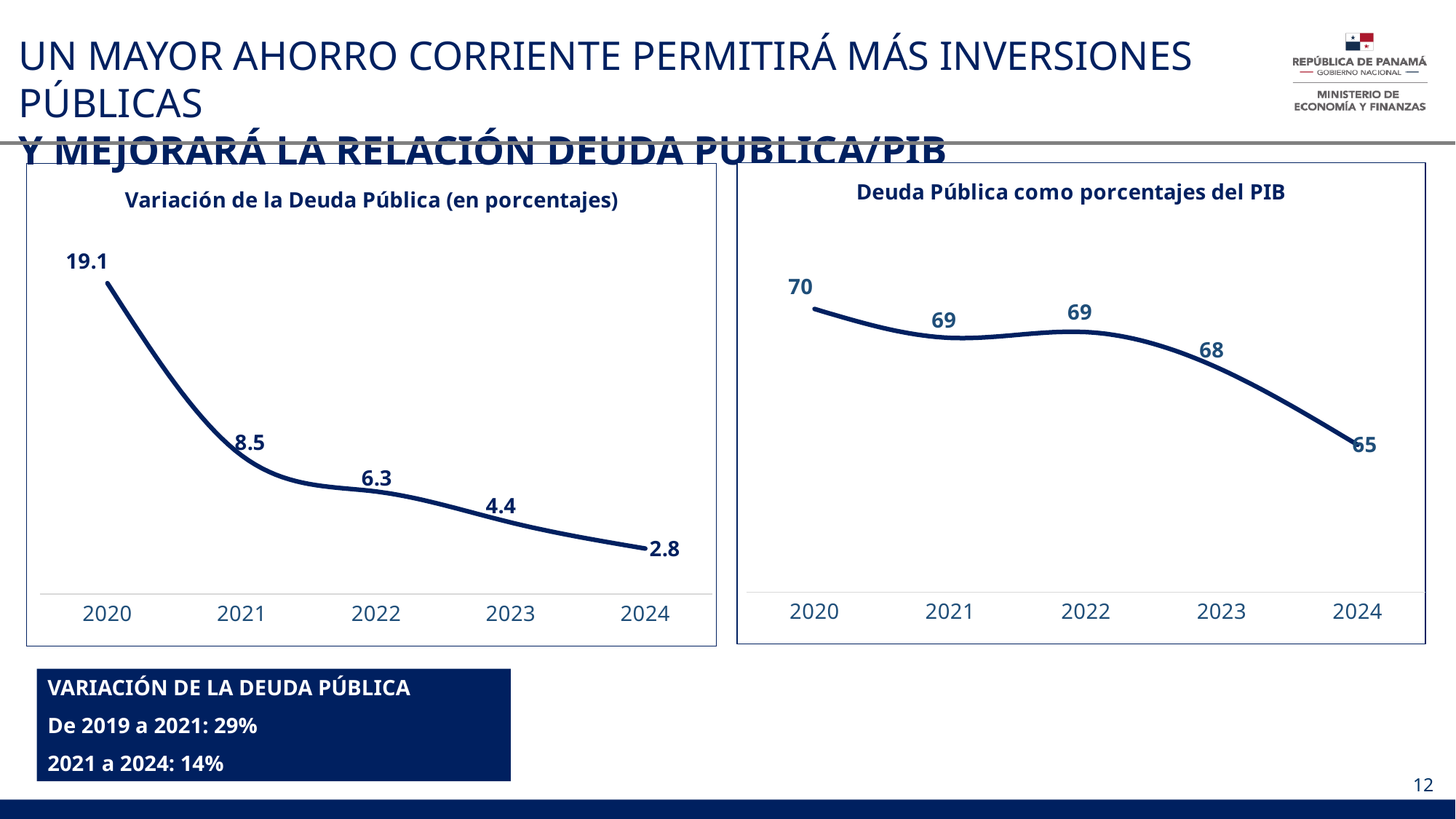
In the chart 'Variación de la Deuda Pública (en porcentajes)', how many years are plotted? 5 In the chart 'Deuda Pública como porcentajes del PIB', which year has the lowest value? 2024 In the chart 'Variación de la Deuda Pública (en porcentajes)', which year has the highest value? 2020 What is the title of the chart on the left side of the slide? Variación de la Deuda Pública (en porcentajes) What kind of chart is 'Deuda Pública como porcentajes del PIB'? line chart In the chart 'Variación de la Deuda Pública (en porcentajes)', do the values rise or fall from 2020 to 2024? fall In the chart 'Deuda Pública como porcentajes del PIB', which is larger, the value for 2020 or the value for 2023? 2020 In the chart 'Deuda Pública como porcentajes del PIB', what is the difference between the 2020 and 2024 values? 5 In the chart 'Deuda Pública como porcentajes del PIB', what is the value for 2023? 68 In the chart 'Variación de la Deuda Pública (en porcentajes)', what is the value for 2020? 19.1 In the chart 'Variación de la Deuda Pública (en porcentajes)', what is the difference between the 2021 and 2022 values? 2.2 In the chart 'Variación de la Deuda Pública (en porcentajes)', what is the value for 2024? 2.8